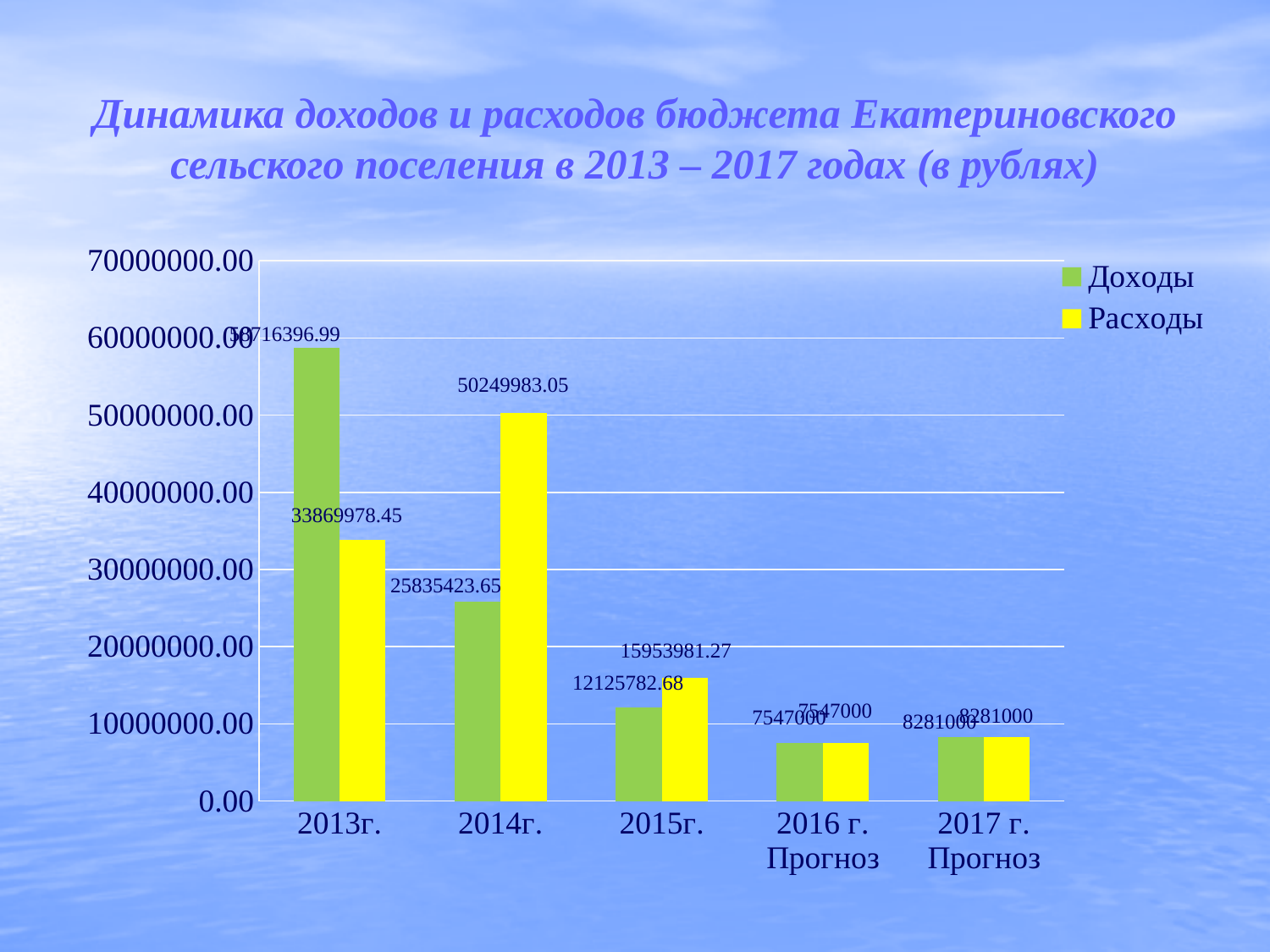
What kind of chart is shown on the slide? Bar chart In which year is Расходы the highest? 2014г. Is the value of Доходы for 2013г. greater or less than 50000000.00? greater How many series does the legend list? 2 In 2014г., which is larger, Доходы or Расходы? Расходы What is the value of Расходы for 2013г.? 33869978.45 What is the value of Доходы for 2015г.? 12125782.68 What is the value of Расходы for 2014г.? 50249983.05 What is the value of Доходы for 2016 г. Прогноз? 7547000 In which year is Доходы the lowest? 2016 г. Прогноз How many year categories are shown on the x axis? 5 What is the difference between Расходы and Доходы in 2015г.? 3828198.59